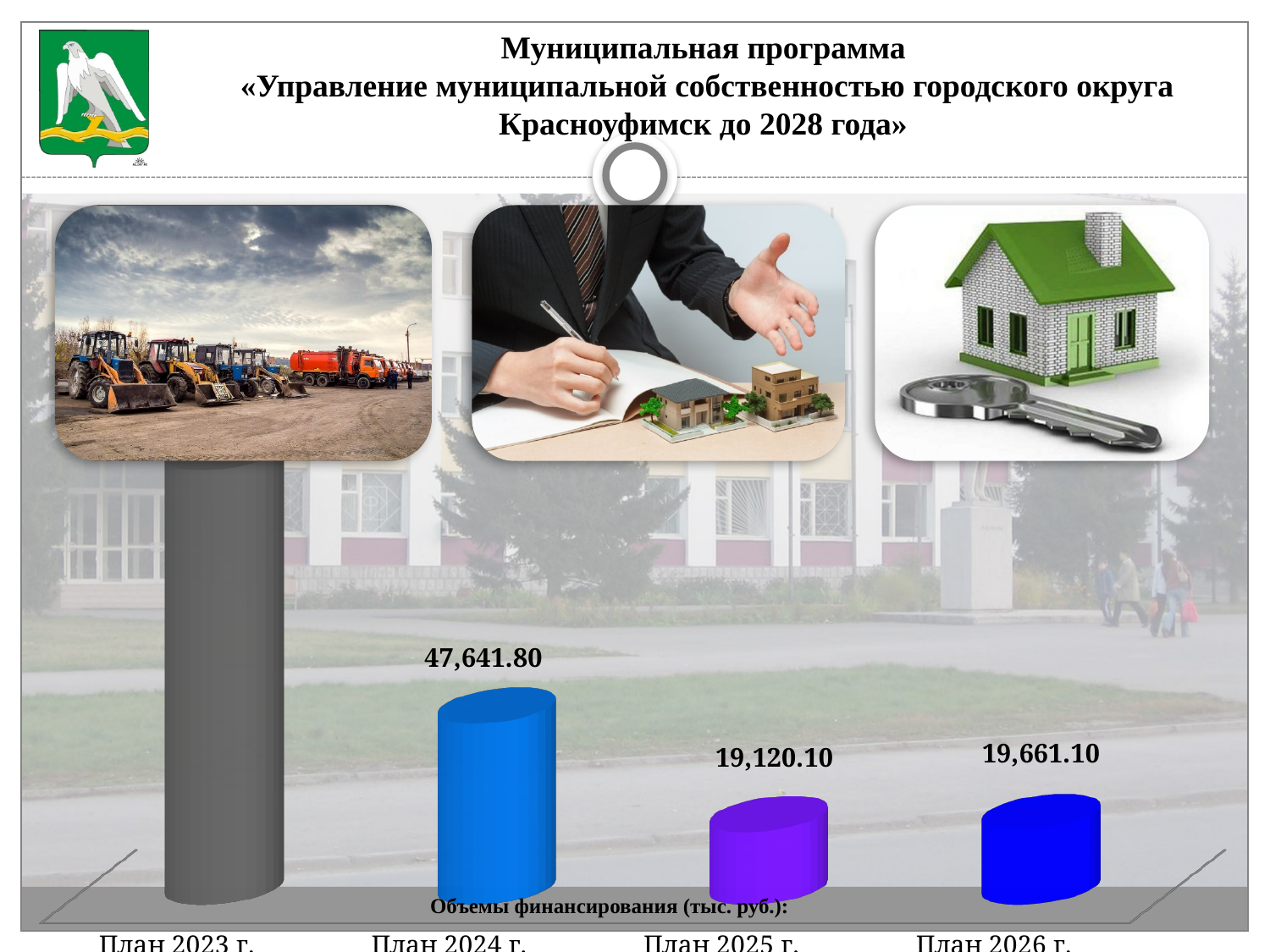
What is the difference between the values for План 2026 г. and План 2025 г.? 541.00 Do the values rise or fall from План 2023 г. to План 2025 г.? Fall What is the value for План 2025 г.? 19,120.10 Which category has the tallest bar? План 2023 г. Which category has the lowest value? План 2025 г. What is the value for План 2026 г.? 19,661.10 Which is larger, the value for План 2024 г. or План 2026 г.? План 2024 г. What is the difference between the values for План 2024 г. and План 2025 г.? 28,521.70 What kind of chart is shown on the slide? Bar chart What unit is stated in the chart's caption for the financing volumes? тыс. руб. How many categories are shown in the chart? 4 What is the value for План 2024 г.? 47,641.80